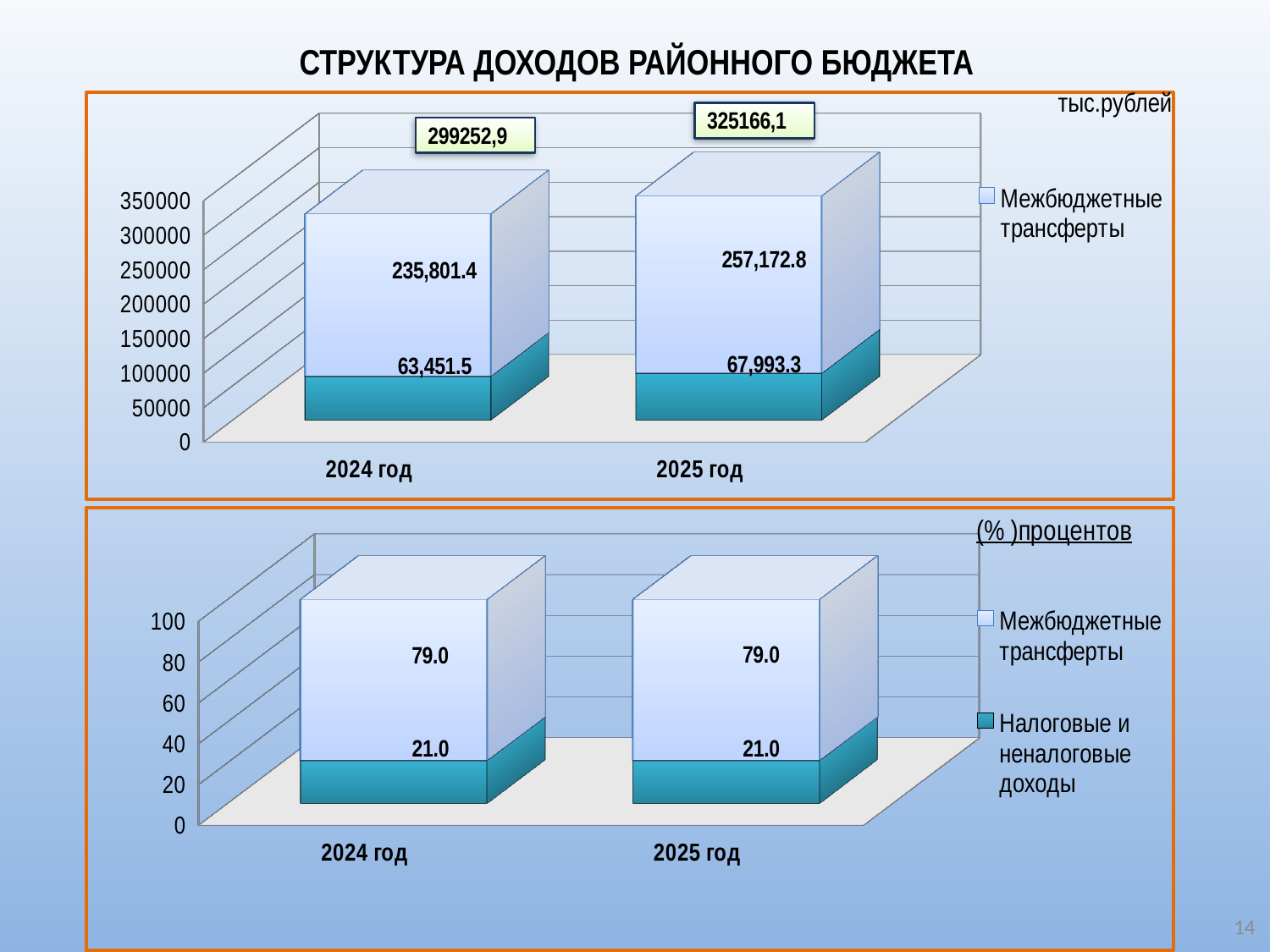
In the bottom chart (проценты), what is the value of Налоговые и неналоговые доходы for 2024 год? 21.0 In the top chart (тыс.рублей), what is the value of Межбюджетные трансферты for 2024 год? 235,801.4 In the top chart (тыс.рублей), is the value of Межбюджетные трансферты for 2024 год greater or less than 200000? greater In the top chart (тыс.рублей), how many year categories are shown on the x axis? 2 In the top chart (тыс.рублей), which year has the larger value for Межбюджетные трансферты? 2025 год In the bottom chart (проценты), what is the value of Межбюджетные трансферты for 2025 год? 79.0 What kind of chart is the bottom chart (проценты)? stacked bar chart In the top chart (тыс.рублей), what is the value of the teal segment (Налоговые и неналоговые доходы) for 2025 год? 67,993.3 In the top chart (тыс.рублей), what total is printed above the 2025 год bar? 325166,1 In the bottom chart (проценты), does the share of Межбюджетные трансферты rise, fall or stay the same from 2024 год to 2025 год? stays the same In the bottom chart (проценты), how many series does the legend list? 2 In the top chart (тыс.рублей), what total is printed above the 2024 год bar? 299252,9